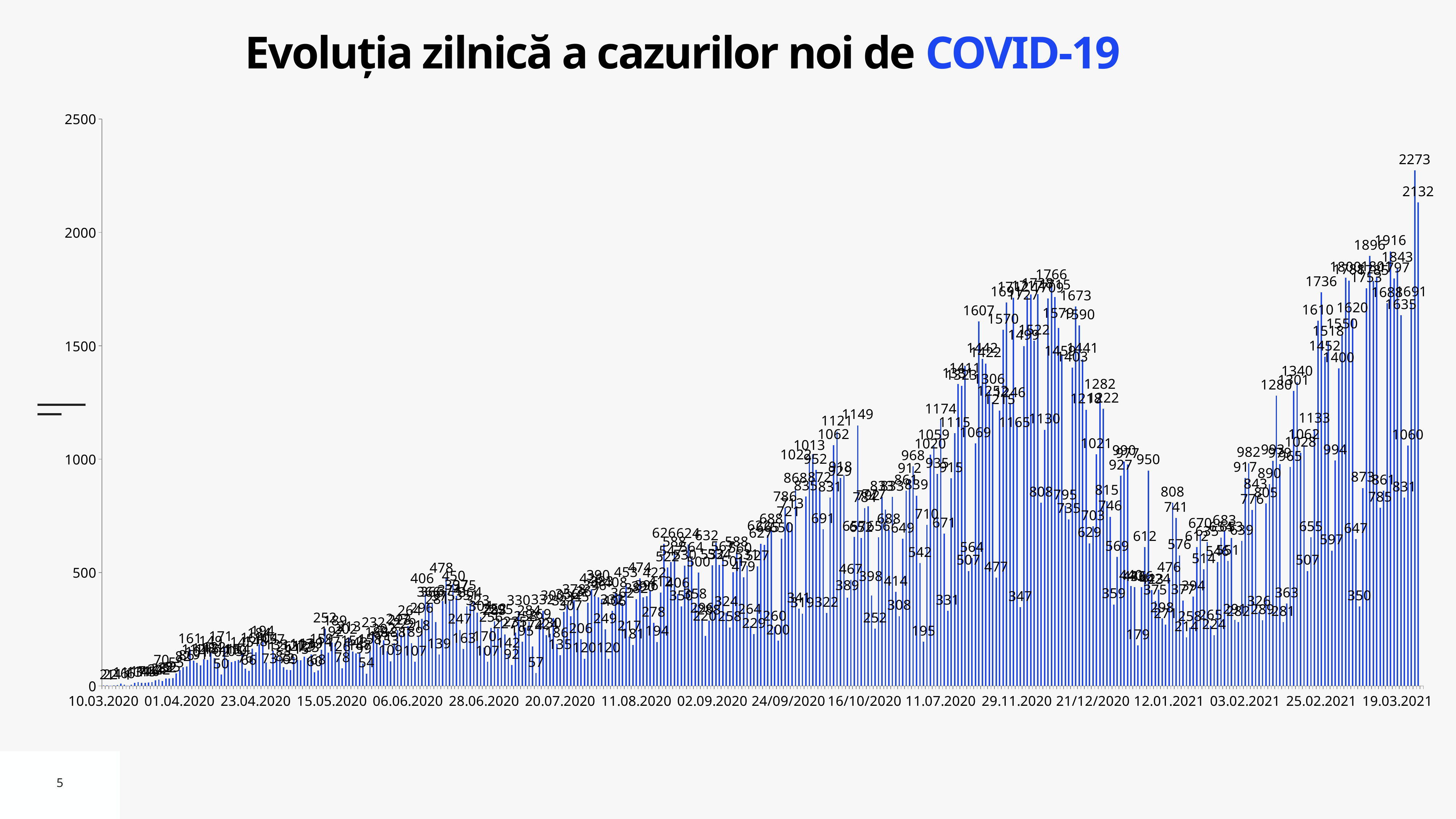
What is the last date label on the horizontal axis? 19.03.2021 Is the highest bar on the chart greater or less than 2000? greater What kind of chart is shown on the slide? bar chart Overall, do the daily case values rise or fall from the start of the x axis to the end? rise What is the highest labelled value in the peak around 29.11.2020? 1766 Which is larger: the peak value around 29.11.2020 (1766) or the peak value in March 2021 (2273)? 2273 (March 2021) What is the difference between the two highest labelled values, 2273 and 2132? 141 What is the highest data label shown on the chart? 2273 What is the highest value shown on the vertical axis? 2500 What is the title of the chart? Evoluția zilnică a cazurilor noi de COVID-19 What is the first date label on the horizontal axis? 10.03.2020 Is the peak value around 29.11.2020 greater or less than 1500? greater